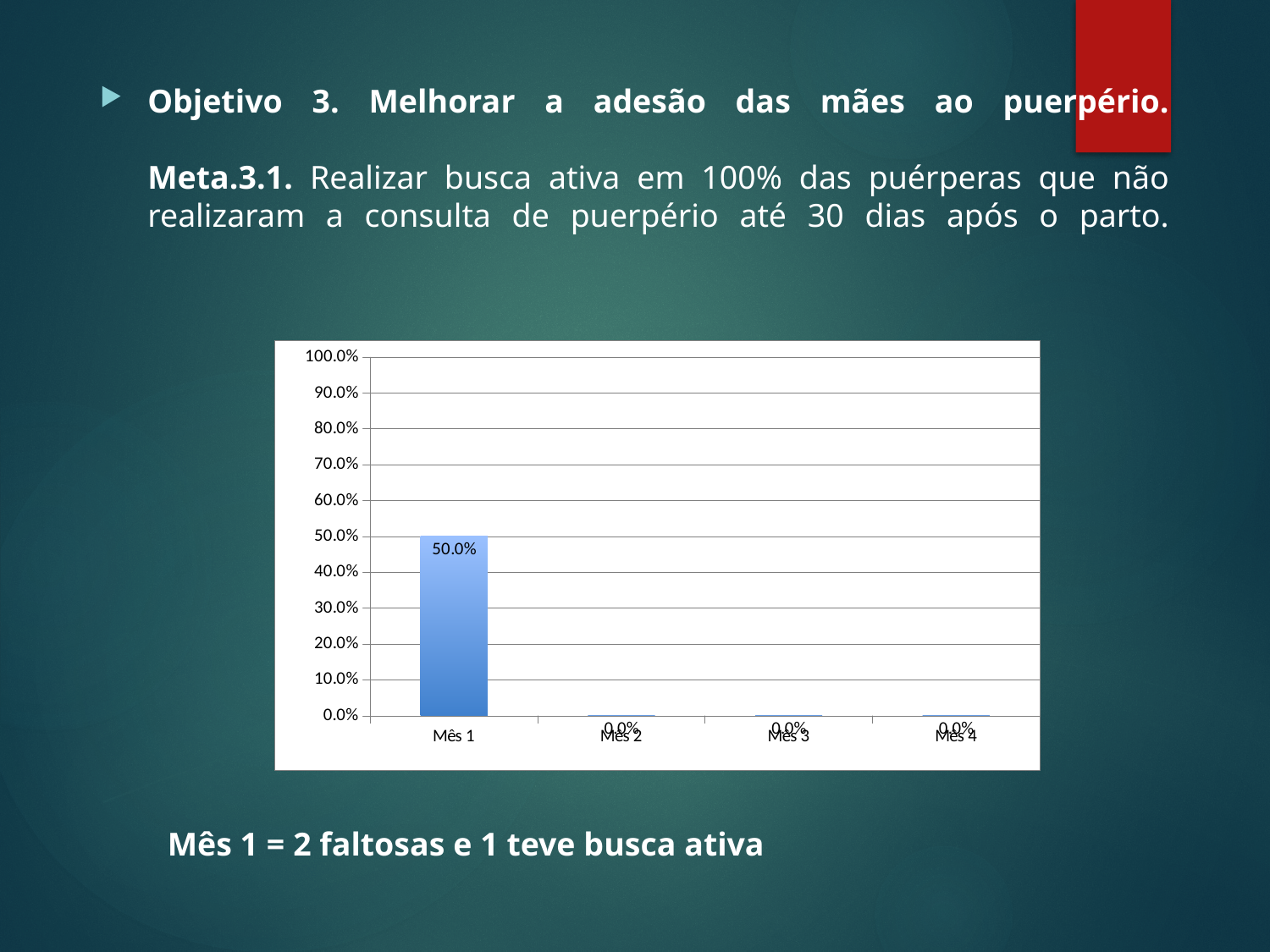
What is the value for Mês 2? 0.0% Which is larger, the value for Mês 1 or the value for Mês 2? Mês 1 What is the highest value shown on the y axis? 100.0% What is the value for Mês 1? 50.0% Do the values rise or fall from Mês 1 to Mês 2? fall How many months are shown on the x axis? 4 What is the value for Mês 4? 0.0% What is the difference between the values for Mês 1 and Mês 3? 50.0% What kind of chart is shown on the slide? bar chart Is the value for Mês 1 greater or less than 60.0%? less Which month has the highest value? Mês 1 How many months have a value of 0.0%? 3